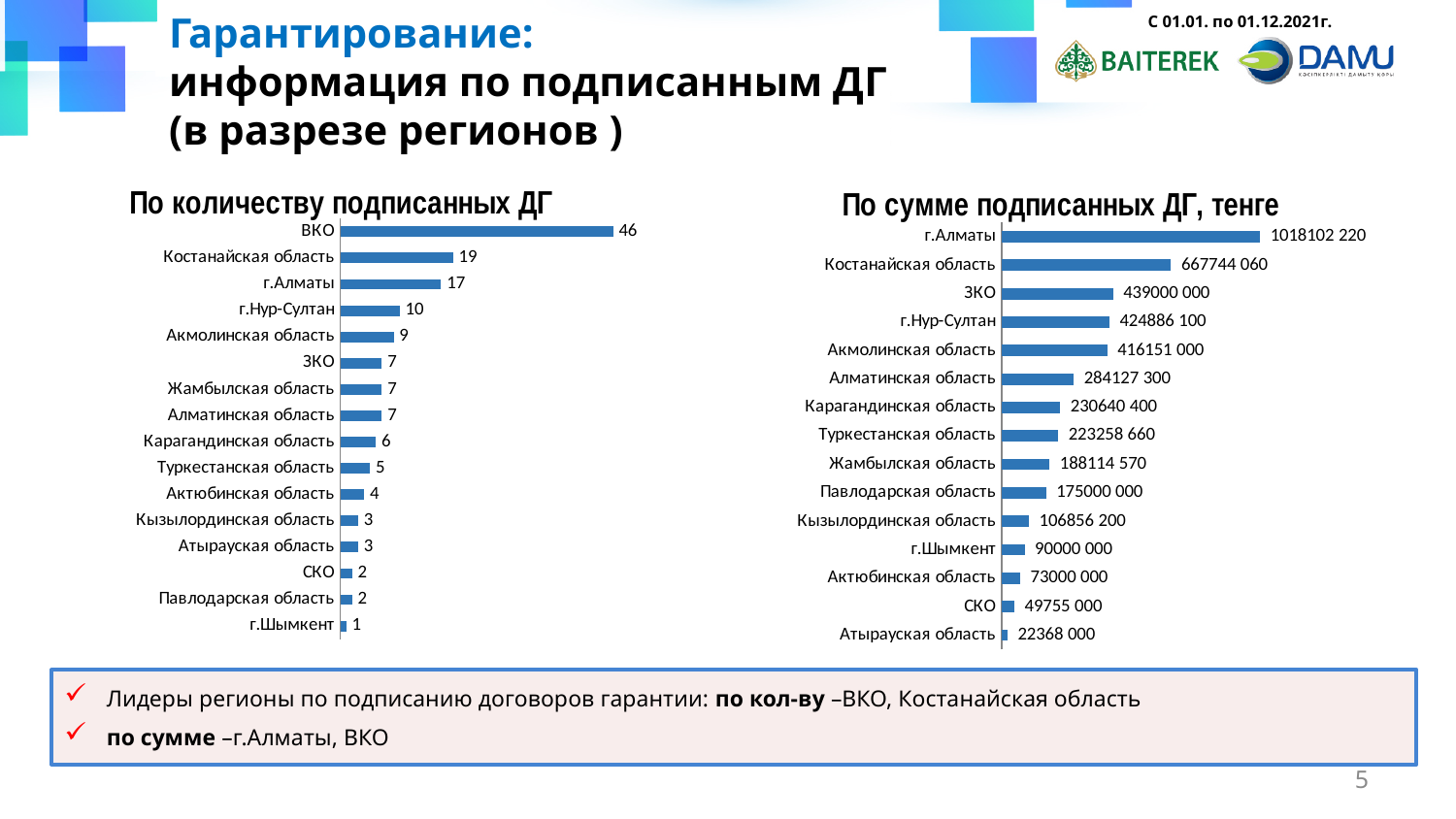
In the chart 'По количеству подписанных ДГ', how many regions are shown? 16 In the chart 'По количеству подписанных ДГ', what is the difference between ВКО and Костанайская область? 27 In the chart 'По сумме подписанных ДГ, тенге', which region has the lowest value? Атырауская область In the chart 'По количеству подписанных ДГ', which is larger: г.Алматы or Акмолинская область? г.Алматы In the chart 'По сумме подписанных ДГ, тенге', what is the value for Павлодарская область? 175000 000 In the chart 'По сумме подписанных ДГ, тенге', how many regions are shown? 15 In the chart 'По количеству подписанных ДГ', what is the value for г.Нур-Султан? 10 In the chart 'По сумме подписанных ДГ, тенге', which region has the highest value? г.Алматы What type of chart is 'По сумме подписанных ДГ, тенге'? Bar chart In the chart 'По количеству подписанных ДГ', what is the value for ВКО? 46 In the chart 'По сумме подписанных ДГ, тенге', what is the value for г.Алматы? 1018102 220 In the chart 'По количеству подписанных ДГ', which region has the lowest value? г.Шымкент